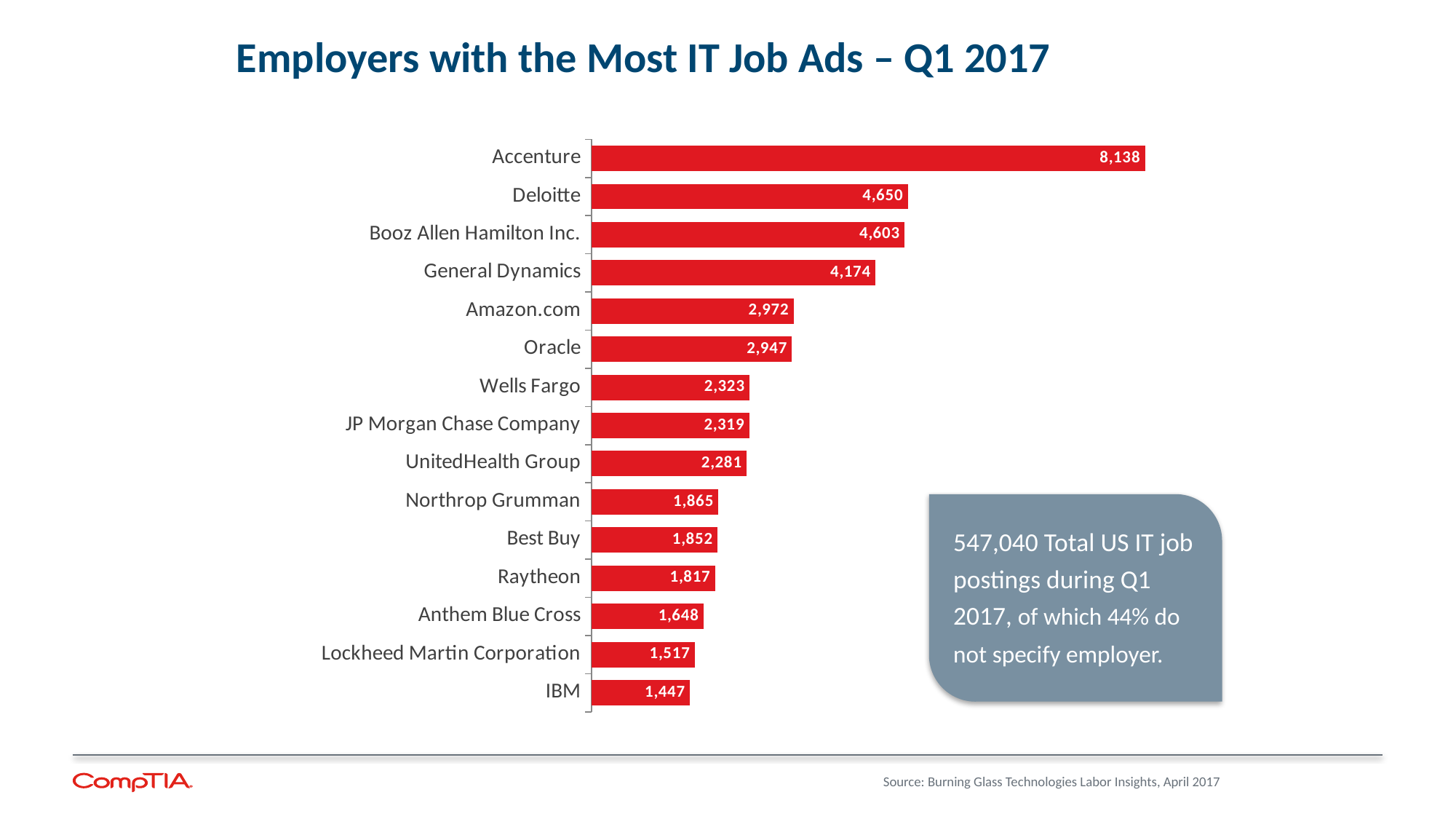
What is the difference between Accenture's and Deloitte's job ad counts? 3,488 Which employer has the fewest IT job ads on the chart? IBM How many IT job ads did Accenture have in Q1 2017? 8,138 What is the title of the chart? Employers with the Most IT Job Ads – Q1 2017 Which employer has the most IT job ads? Accenture What is the difference between Amazon.com's and Wells Fargo's values? 649 What kind of chart is shown on the slide? Bar chart What is the value shown for Oracle? 2,947 Which has more IT job ads, General Dynamics or Amazon.com? General Dynamics What is the value shown for Lockheed Martin Corporation? 1,517 Which has more IT job ads, Raytheon or Anthem Blue Cross? Raytheon How many employers are shown on the chart? 15